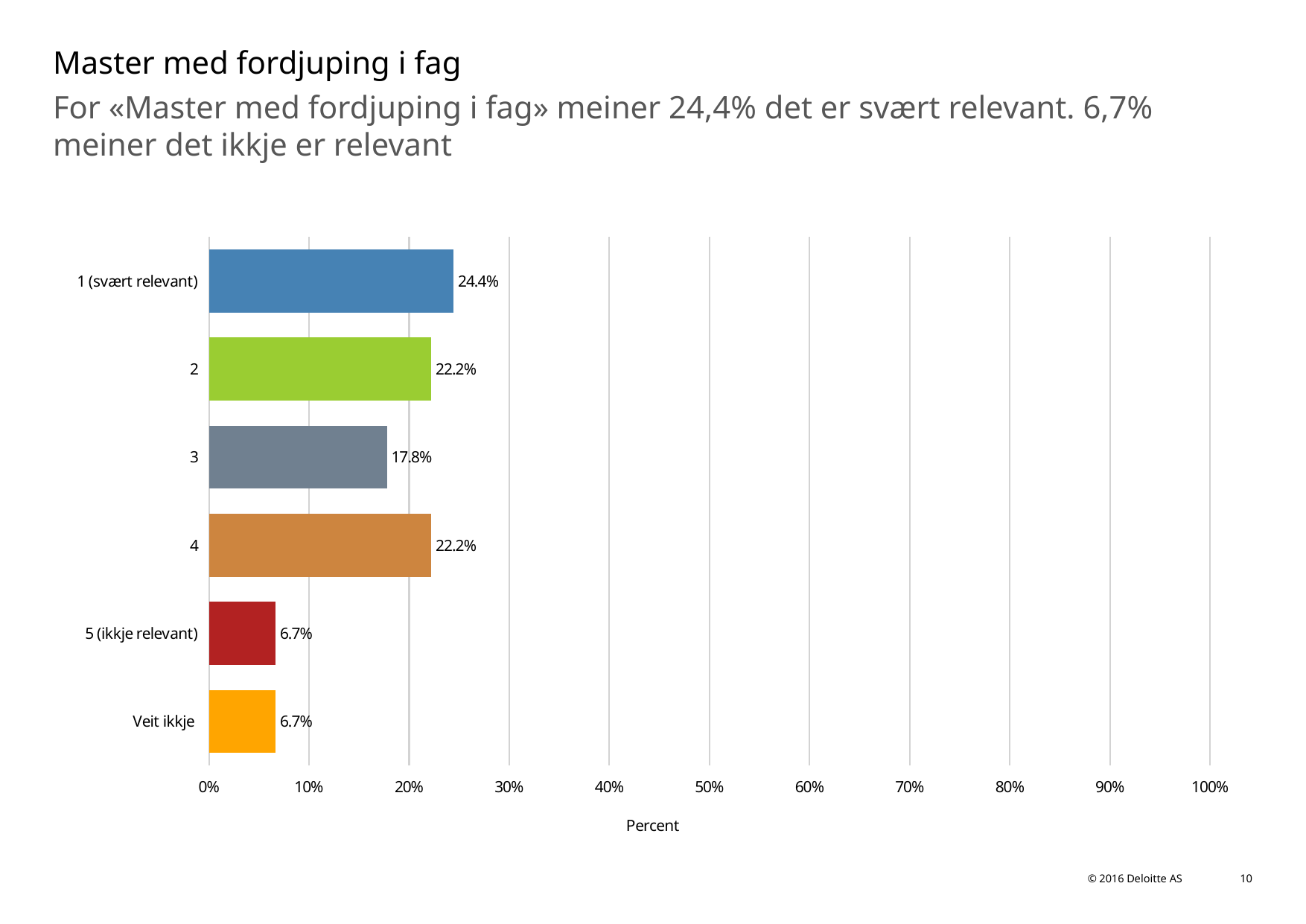
What is the value for "1 (svært relevant)"? 24.4% What kind of chart is shown on the slide? Bar chart What is the value for "Veit ikkje"? 6.7% What is the difference between the values for "1 (svært relevant)" and "3"? 6.6% Is the value for "5 (ikkje relevant)" greater or less than 10%? less What is the label of the horizontal axis? Percent Is the value for "4" greater or less than 20%? greater What is the value for category "3"? 17.8% Which is larger, the value for "2" or the value for "3"? 2 Which category has the highest value? 1 (svært relevant) What is the difference between the values for "2" and "5 (ikkje relevant)"? 15.5% How many categories are shown in the chart? 6